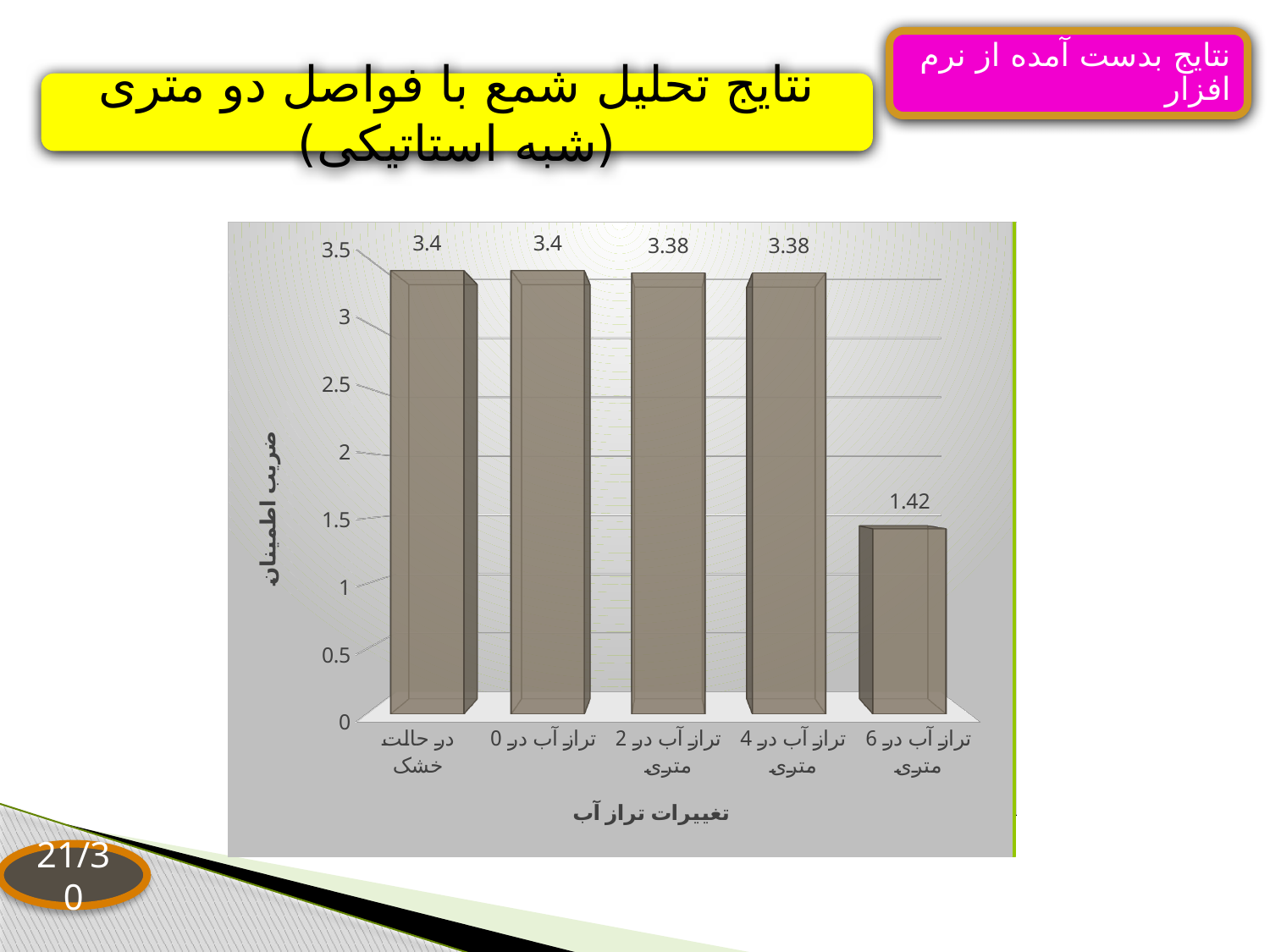
Which is larger, the value for "در حالت خشک" or the value for "تراز آب در 6 متری"? در حالت خشک What kind of chart is shown on the slide? bar chart What is the value for "تراز آب در 2 متری"? 3.38 How many categories are shown on the x axis? 5 Is the value for "تراز آب در 4 متری" greater or less than 3? greater What is the value for "در حالت خشک"? 3.4 Is the value for "تراز آب در 6 متری" greater or less than 2? less What is the title of the x axis? تغییرات تراز آب What is the difference between the values for "تراز آب در 0 متری" and "تراز آب در 2 متری"? 0.02 Which category has the lowest value? تراز آب در 6 متری What is the value for "تراز آب در 6 متری"? 1.42 What is the difference between the values for "تراز آب در 4 متری" and "تراز آب در 6 متری"? 1.96